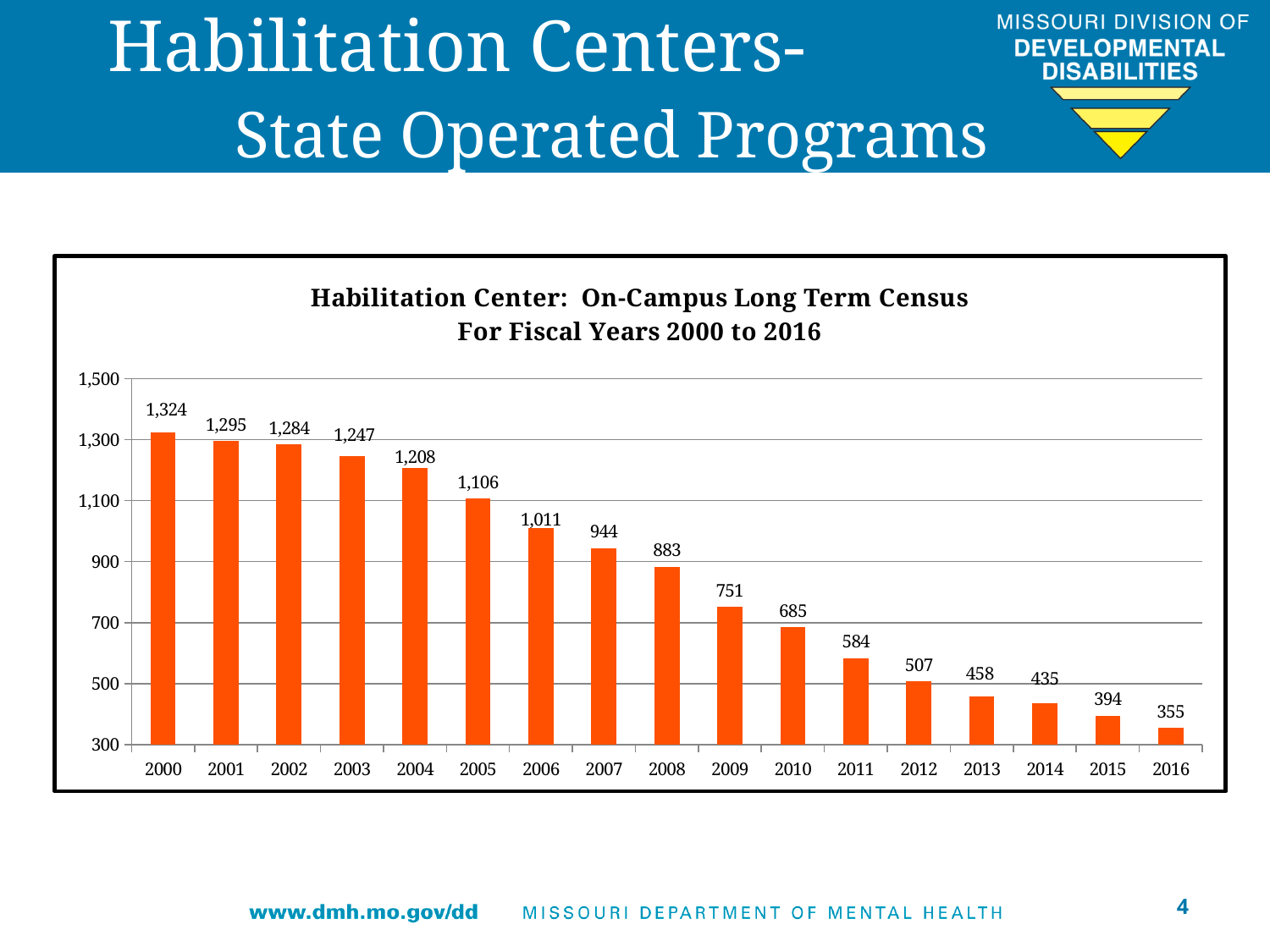
What is the difference between the census values for 2005 and 2006? 95 Which fiscal year has the highest census value? 2000 How many fiscal years are shown on the x axis? 17 What kind of chart is shown on the slide? Bar chart Do the census values rise or fall from 2000 to 2016? Fall Which fiscal year has the lowest census value? 2016 What is the census value shown for fiscal year 2009? 751 Is the census value for 2011 greater or less than 500? greater What is the difference between the census values for 2000 and 2016? 969 What is the on-campus long term census value for fiscal year 2000? 1,324 What is the census value shown for fiscal year 2016? 355 Which is larger, the census value for 2007 or for 2008? 2007